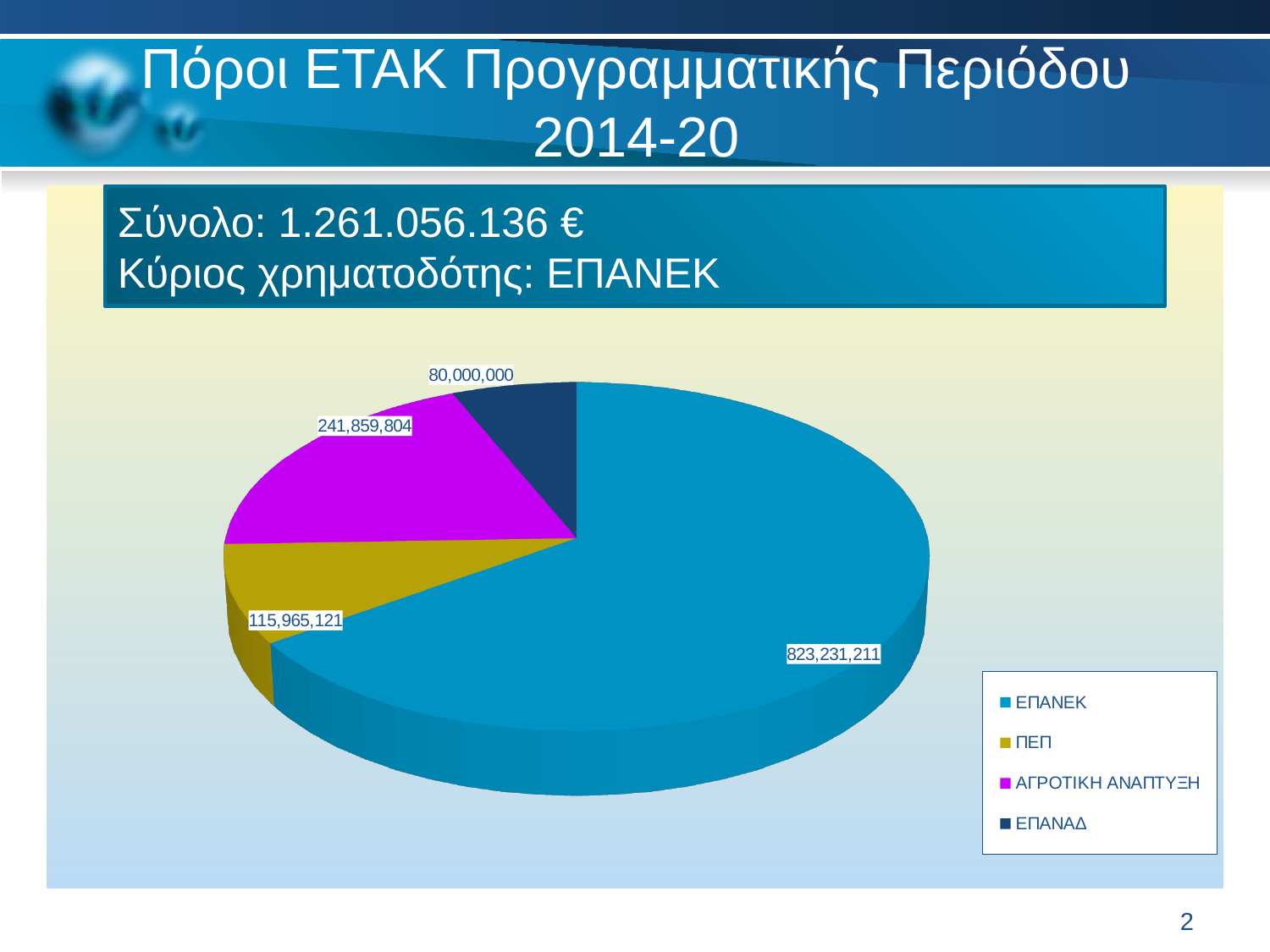
What is the value for ΠΕΠ in the pie chart? 115,965,121 What colour is the ΑΓΡΟΤΙΚΗ ΑΝΑΠΤΥΞΗ slice in the pie chart? Magenta What is the difference between the values for ΕΠΑΝΕΚ and ΑΓΡΟΤΙΚΗ ΑΝΑΠΤΥΞΗ? 581,371,407 What is the value for ΕΠΑΝΑΔ in the pie chart? 80,000,000 What kind of chart is shown on the slide? Pie chart Which is larger, the value for ΠΕΠ or the value for ΑΓΡΟΤΙΚΗ ΑΝΑΠΤΥΞΗ? ΑΓΡΟΤΙΚΗ ΑΝΑΠΤΥΞΗ What is the value for ΑΓΡΟΤΙΚΗ ΑΝΑΠΤΥΞΗ in the pie chart? 241,859,804 What is the value for ΕΠΑΝΕΚ in the pie chart? 823,231,211 Which category has the smallest slice in the pie chart? ΕΠΑΝΑΔ What is the difference between the values for ΠΕΠ and ΕΠΑΝΑΔ? 35,965,121 How many categories does the legend of the pie chart list? 4 Which category has the largest slice in the pie chart? ΕΠΑΝΕΚ